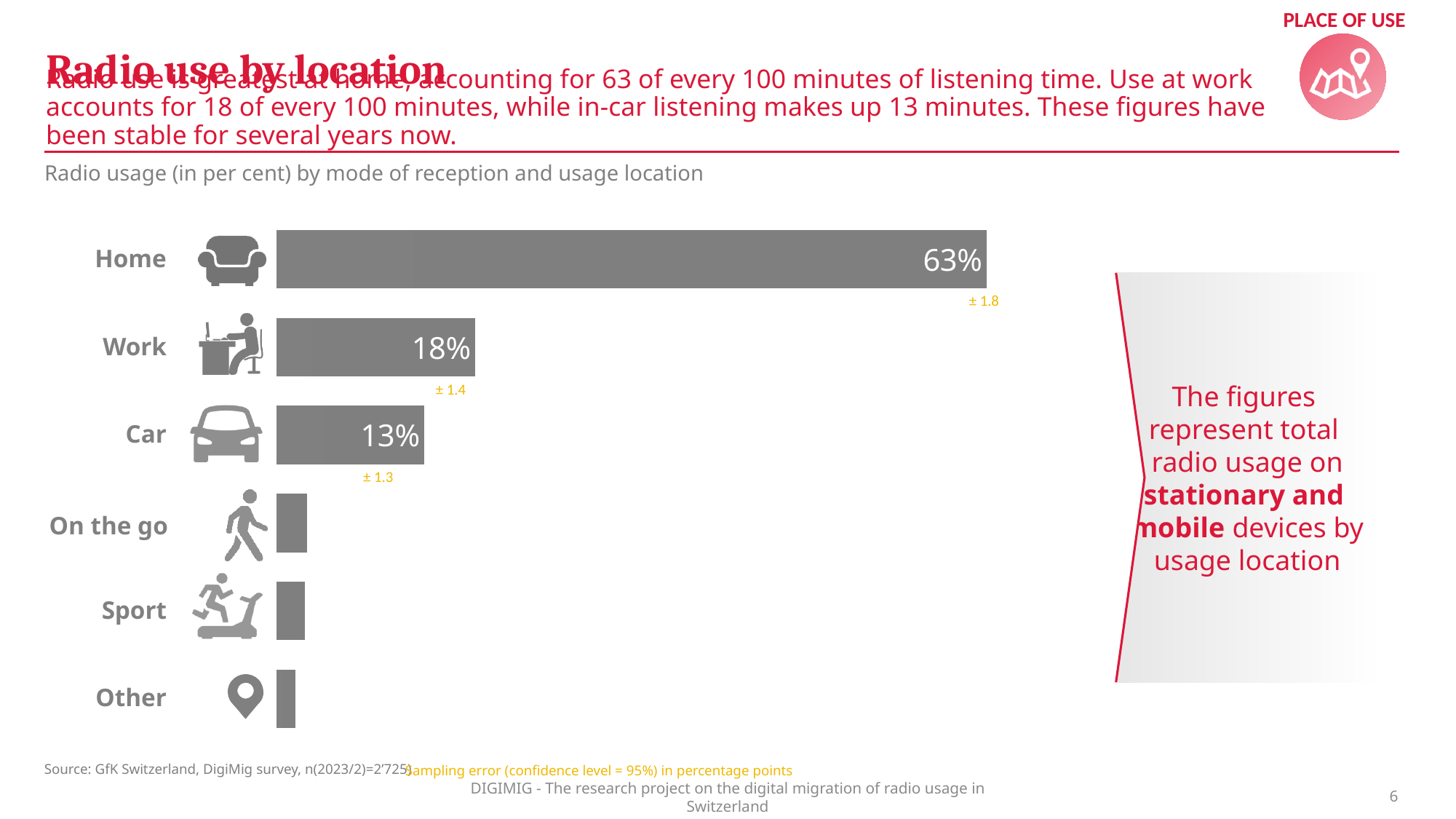
What is the subtitle describing the chart? Radio usage (in per cent) by mode of reception and usage location What is the difference in percentage points between Work and Car? 5 Which is larger, the value for Car or the value for On the go? Car How many usage locations are shown in the chart? 6 Which usage location has the lowest radio usage? Other What is the difference in percentage points between Home and Work? 45 What is the value shown for Work? 18% What is the value shown for Car? 13% What is the sampling error shown for the Home bar? ± 1.8 Which usage location has the highest radio usage? Home What kind of chart is used on this slide? Bar chart What percentage of radio usage takes place at home? 63%